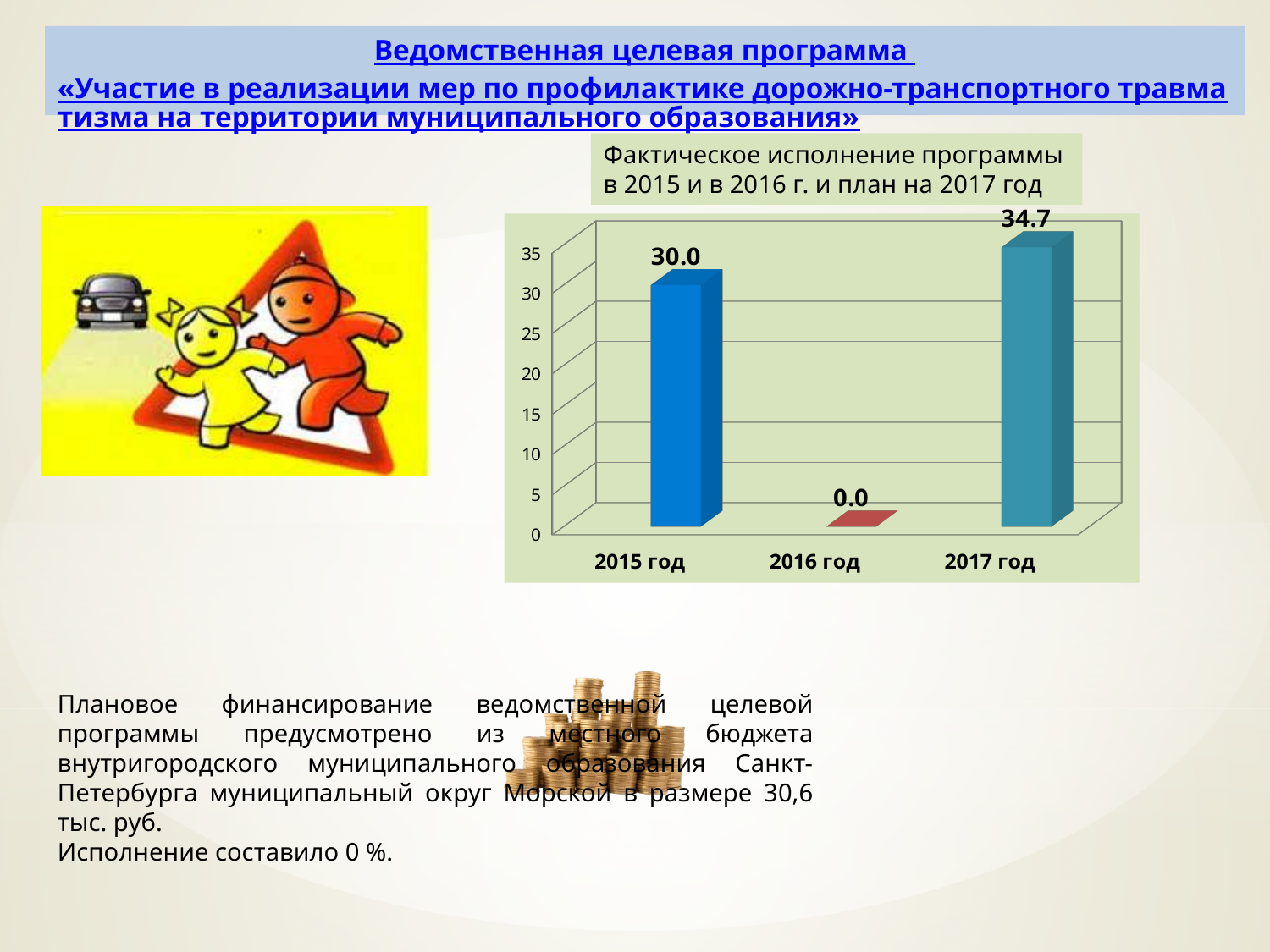
How many categories are shown on the x axis? 3 What is the value for 2016 год? 0.0 What is the title of the chart? Фактическое исполнение программы в 2015 и в 2016 г. и план на 2017 год What is the value for 2015 год? 30.0 Is the value for 2015 год greater or less than 25? greater Which year has the lowest value? 2016 год What is the difference between the values for 2017 год and 2015 год? 4.7 Which year has the highest value? 2017 год What is the highest tick value shown on the vertical axis? 35 Which is larger, the value for 2015 год or the value for 2017 год? 2017 год What kind of chart is shown on the slide? bar chart What is the value for 2017 год? 34.7